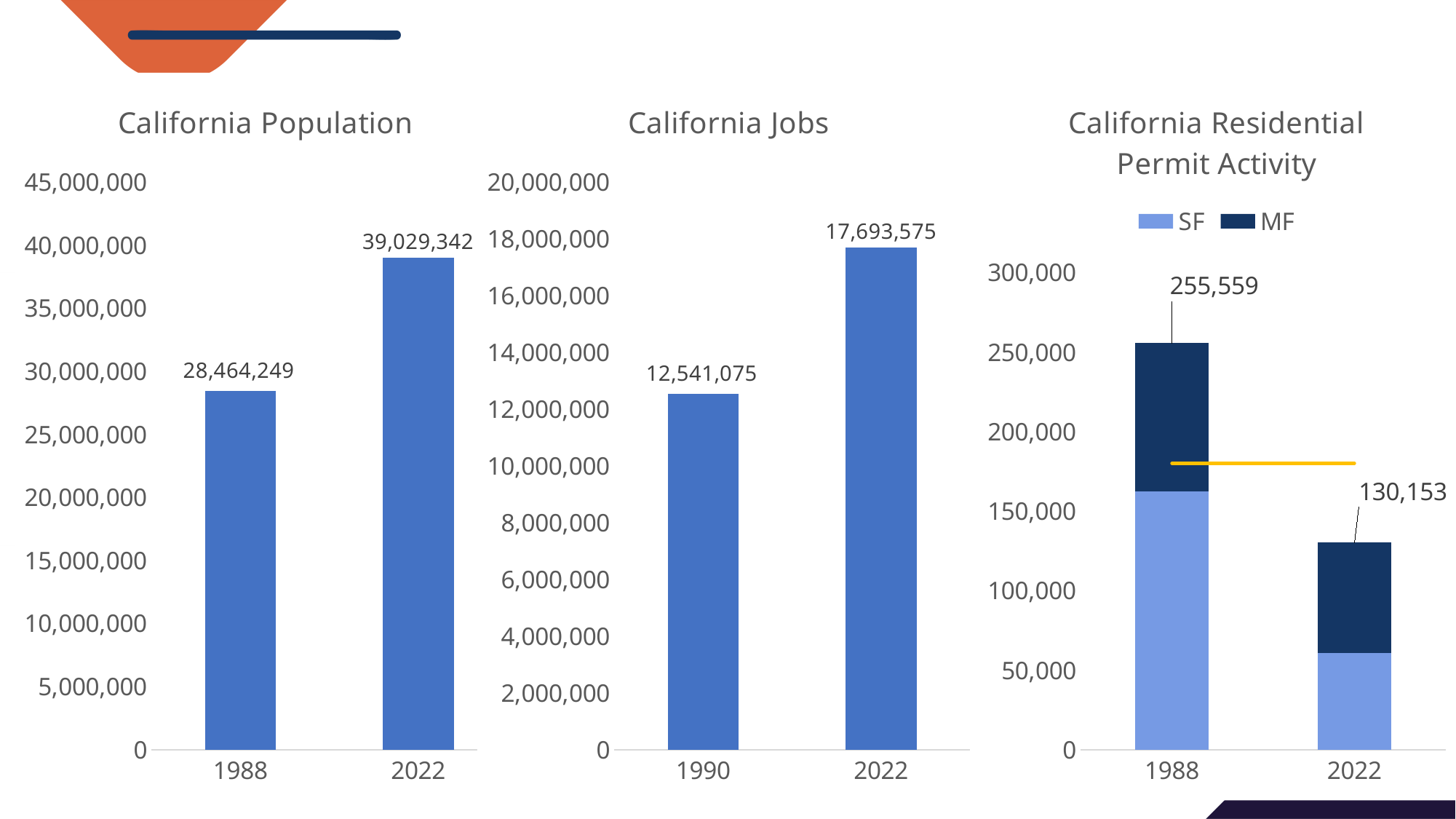
In the California Residential Permit Activity chart, what is the total for the 2022 bar? 130,153 In the California Jobs chart, which year has the higher value? 2022 In the California Residential Permit Activity chart, how many series does the legend list? 2 In the California Jobs chart, what is the value for 1990? 12,541,075 In the California Population chart, what is the value for 2022? 39,029,342 In the California Residential Permit Activity chart, is the SF value for 1988 greater or less than 150,000? greater In the California Jobs chart, what is the value for 2022? 17,693,575 In the California Population chart, what is the difference between the 2022 and 1988 values? 10,565,093 In the California Residential Permit Activity chart, do the totals rise or fall from 1988 to 2022? fall In the California Jobs chart, what is the difference between the 2022 and 1990 values? 5,152,500 In the California Population chart, what is the value for 1988? 28,464,249 In the California Residential Permit Activity chart, what is the total for the 1988 bar? 255,559